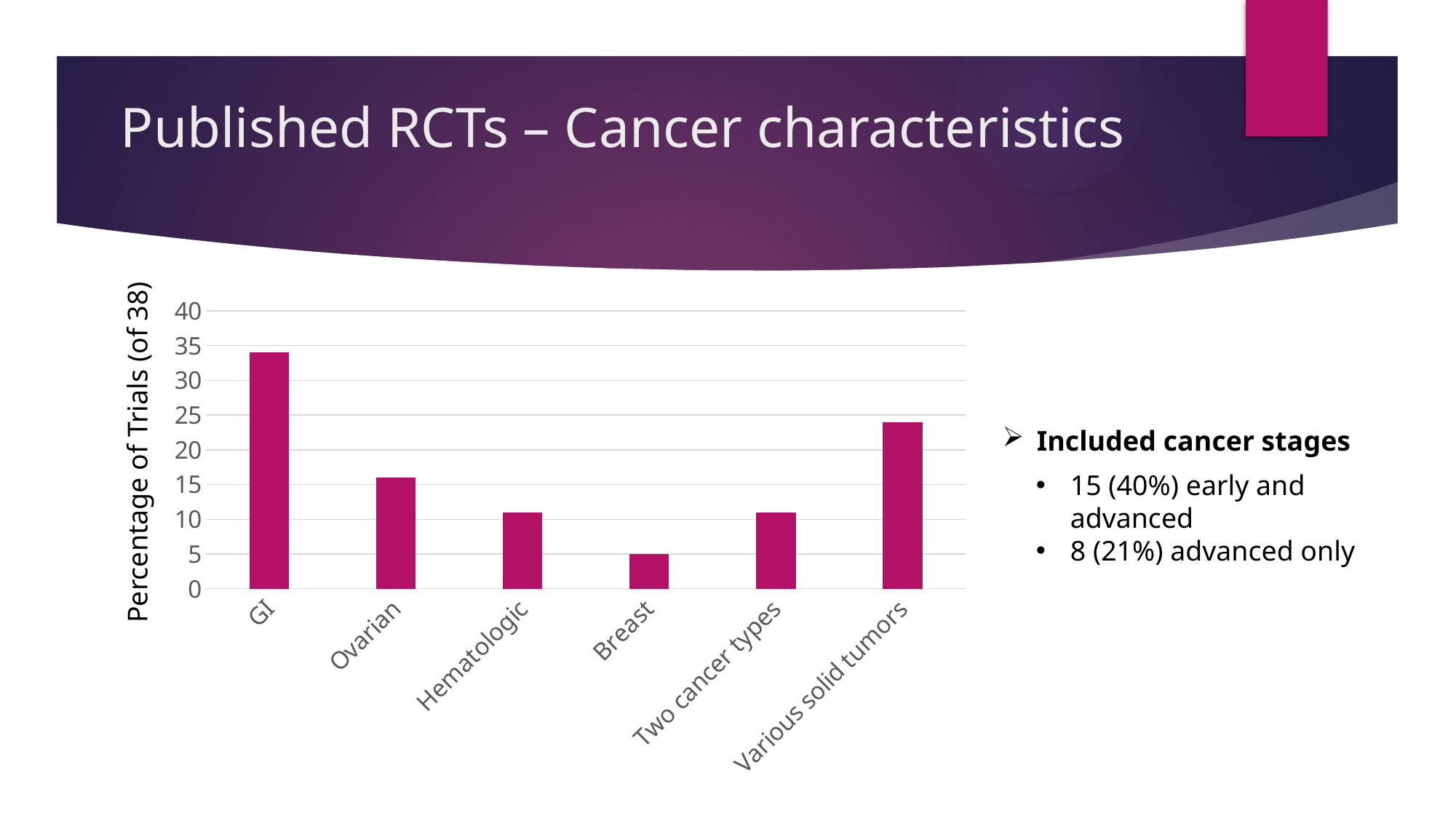
Is the value for Various solid tumors greater or less than 20? greater Is the value for Ovarian greater or less than 20? less Which category has the lowest percentage of trials? Breast Which is larger, the value for Breast or the value for Hematologic? Hematologic What is the maximum value shown on the y axis of the chart? 40 Which is larger, the value for Ovarian or the value for Various solid tumors? Various solid tumors Is the value for GI greater or less than 30? greater What kind of chart is shown on the slide? bar chart How many cancer categories are shown on the x axis of the chart? 6 What is the label of the y axis of the chart? Percentage of Trials (of 38) Which category has the highest percentage of trials? GI